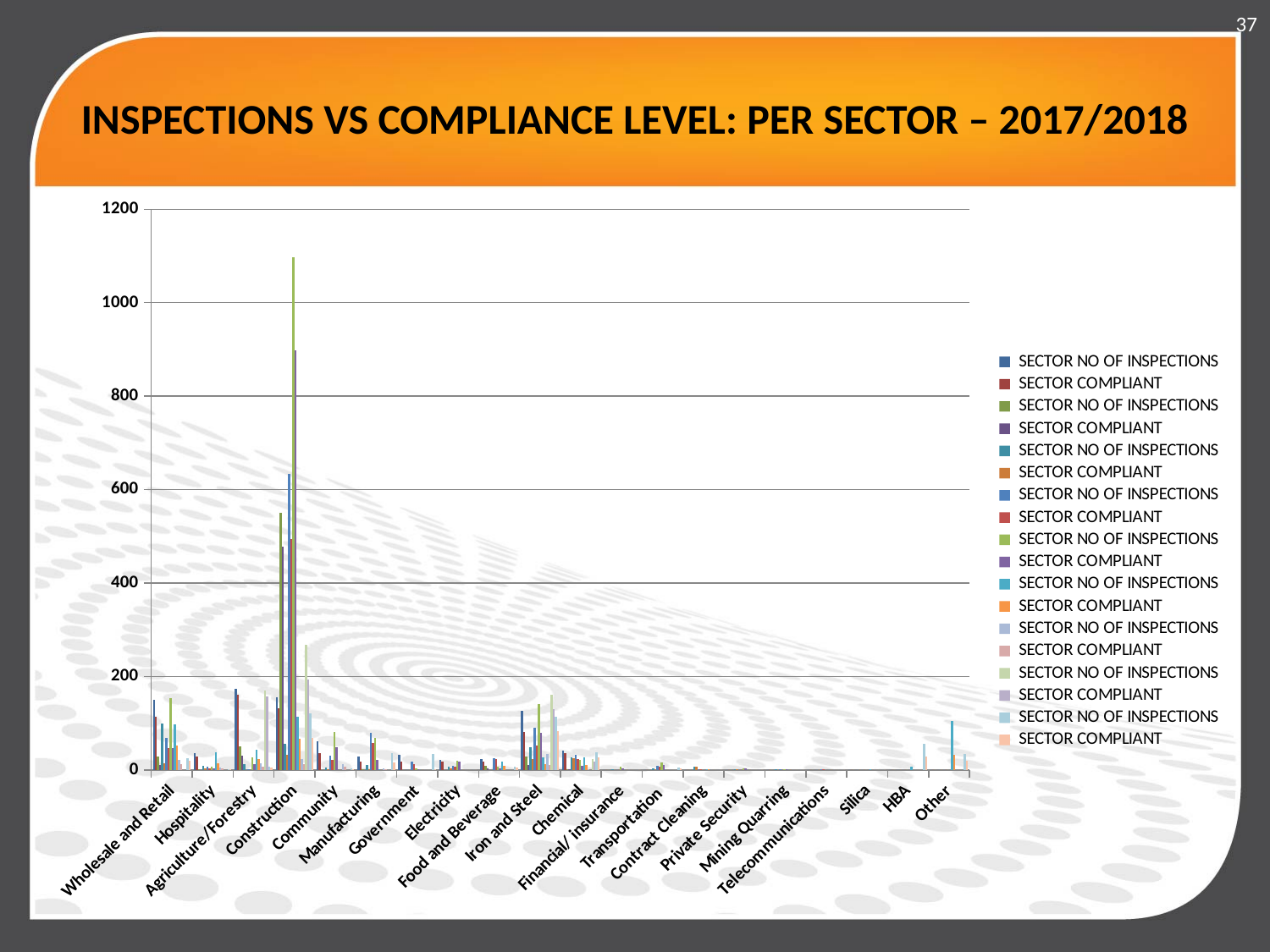
Which is the first sector category listed on the x axis of the chart? Wholesale and Retail What is the title of the chart on the slide? INSPECTIONS VS COMPLIANCE LEVEL: PER SECTOR – 2017/2018 Is the tallest bar for Construction greater or less than 1000? greater What kind of chart is shown on the slide? bar chart Is the tallest bar for Iron and Steel greater or less than 200? less Which sector has the tallest bar in the chart? Construction Is the tallest bar for Wholesale and Retail greater or less than 200? less How many series does the chart's legend list? 18 What is the highest value shown on the vertical axis of the chart? 1200 Which sector has taller bars overall, Construction or Manufacturing? Construction How many sector categories are shown along the x axis of the chart? 20 Which sector has taller bars overall, Iron and Steel or Telecommunications? Iron and Steel